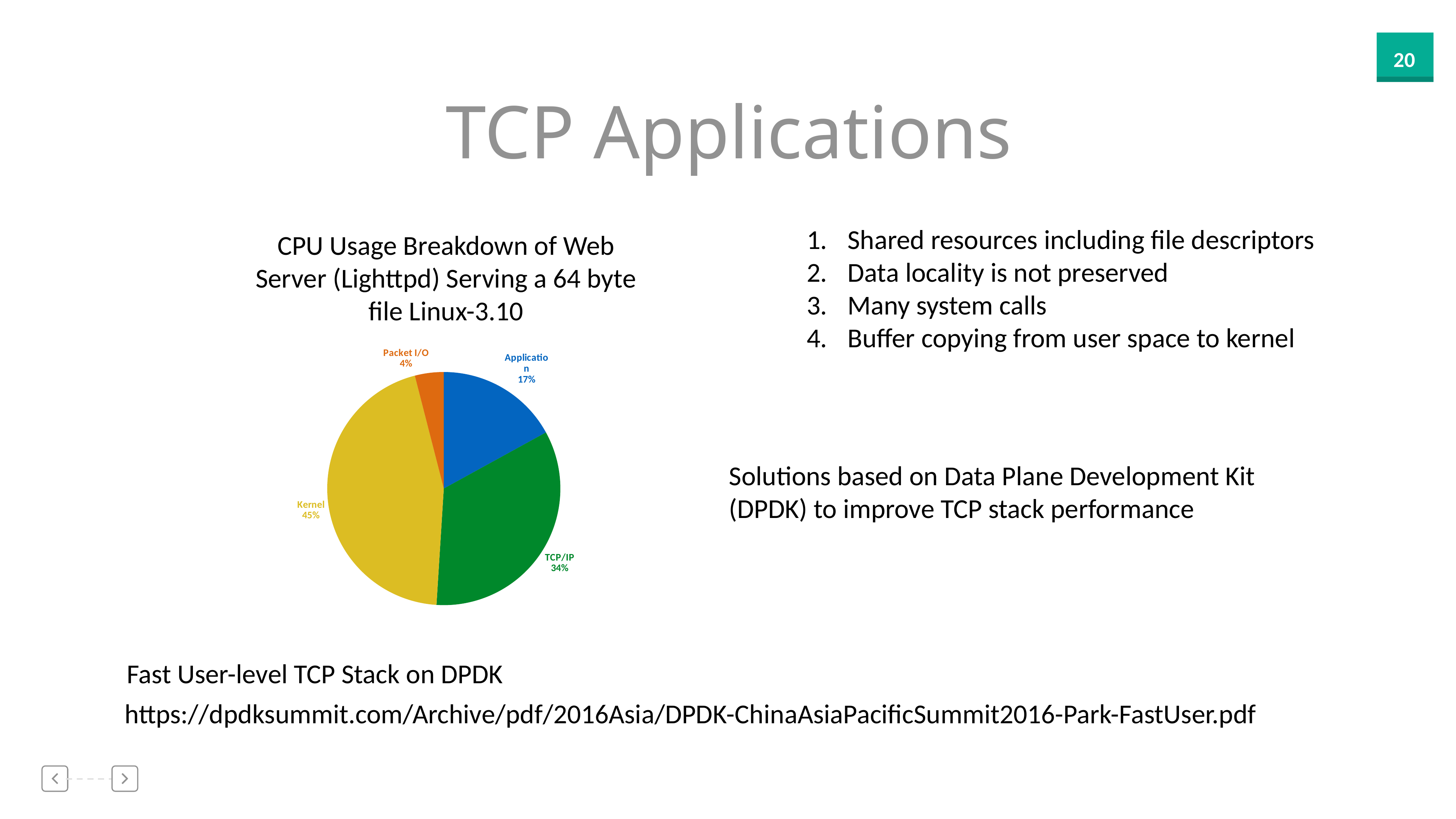
What is the title of the chart? CPU Usage Breakdown of Web Server (Lighttpd) Serving a 64 byte file Linux-3.10 What share of CPU usage does the Application slice represent? 17% Which is larger, the Application slice or the TCP/IP slice? TCP/IP What colour is the Kernel slice in the pie chart? yellow How many slices does the pie chart have? 4 What share of CPU usage does the Packet I/O slice represent? 4% Which slice of the pie chart is the smallest? Packet I/O What share of CPU usage does the TCP/IP slice represent? 34% What kind of chart is shown on the slide? pie chart What is the difference in percentage points between the Kernel and TCP/IP slices? 11 Which slice of the pie chart is the largest? Kernel